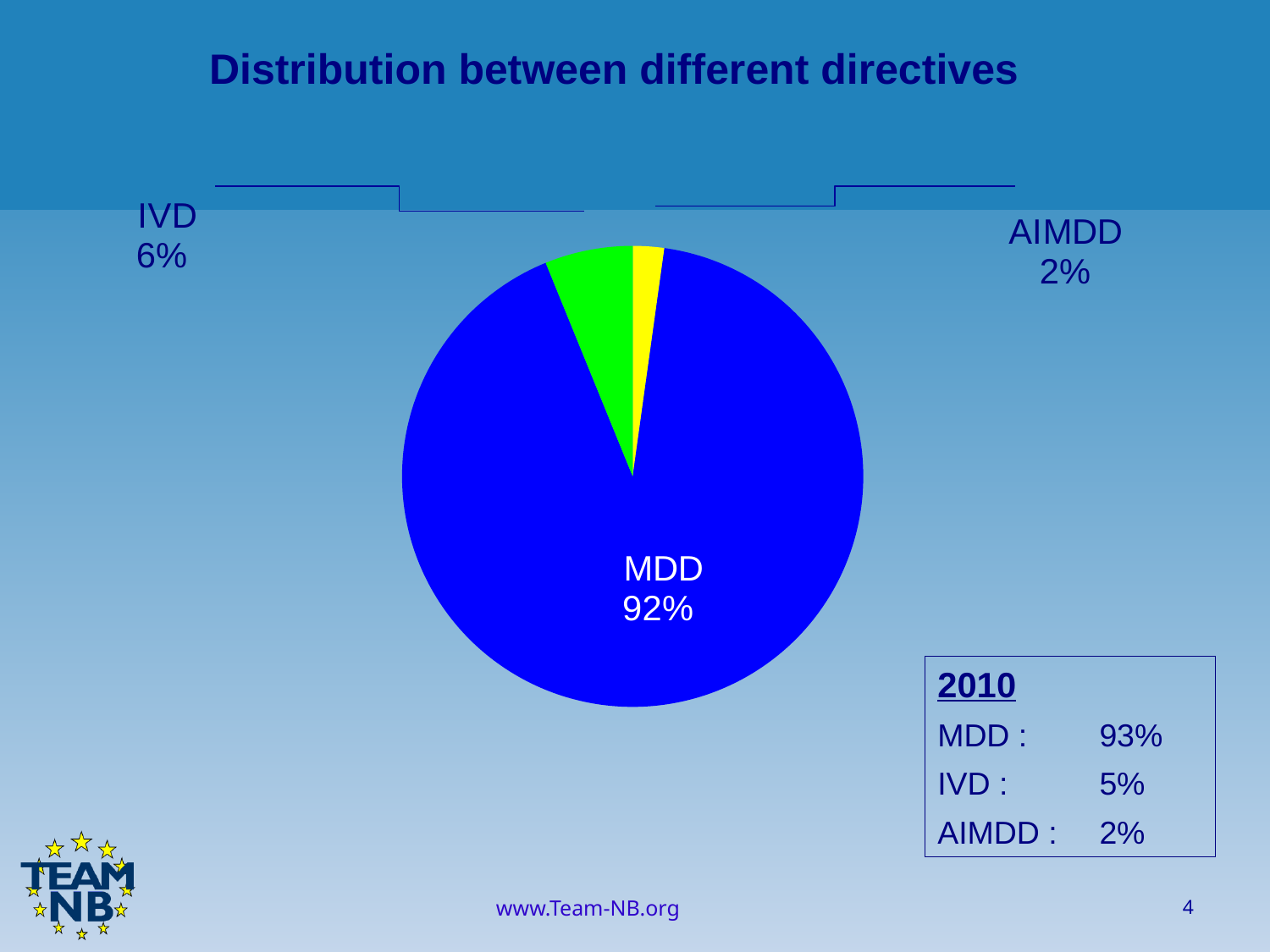
What is the difference in percentage points between the MDD and IVD slices? 86 What share of the pie does MDD have? 92% What share of the pie does AIMDD have? 2% How many slices does the pie chart have? 3 What is the difference in percentage points between the IVD and AIMDD slices? 4 What is the title of the chart? Distribution between different directives What kind of chart is shown on the slide? pie chart Which directive has the smallest slice of the pie? AIMDD What colour is the MDD slice of the pie? blue Which directive has the largest slice of the pie? MDD Which slice is larger, IVD or AIMDD? IVD What share of the pie does IVD have? 6%